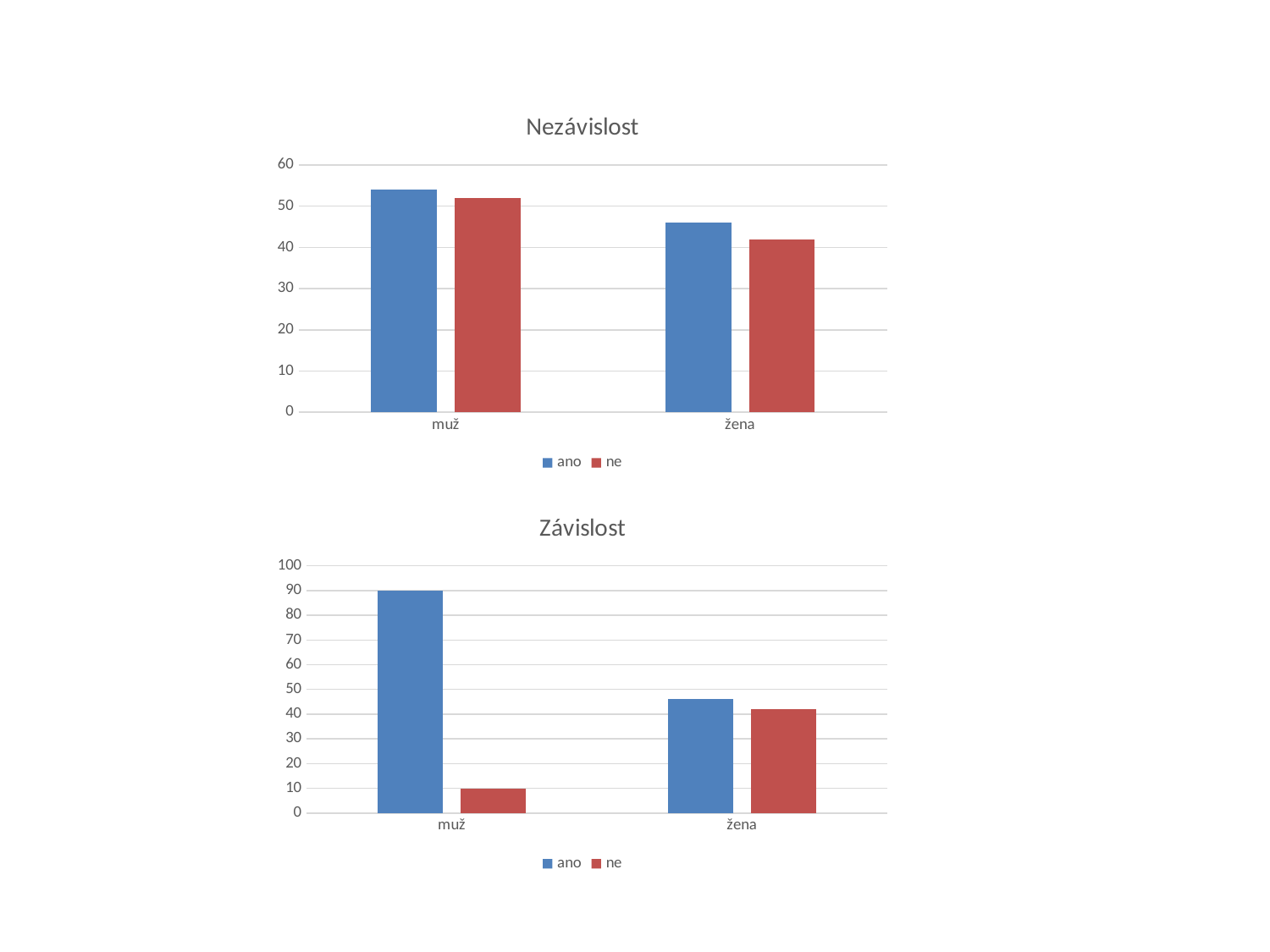
In the Závislost chart, which bar is the shortest? ne for muž In the Závislost chart, what is the value of 'ne' for muž? 10 In the Závislost chart, is the value of 'ano' for žena greater or less than 50? less How many categories are shown on the x axis of the Závislost chart? 2 In the Závislost chart, what is the value of 'ano' for muž? 90 In the Závislost chart, which bar is the tallest? ano for muž In the Nezávislost chart, is the value of 'ne' for žena greater or less than 50? less In the Nezávislost chart, which is larger: 'ano' for muž or 'ano' for žena? ano for muž What type of chart is the Nezávislost chart? bar chart In the Nezávislost chart, is the value of 'ano' for muž greater or less than 50? greater How many series does the legend of the Nezávislost chart list? 2 In the Závislost chart, what is the difference between 'ano' and 'ne' for muž? 80